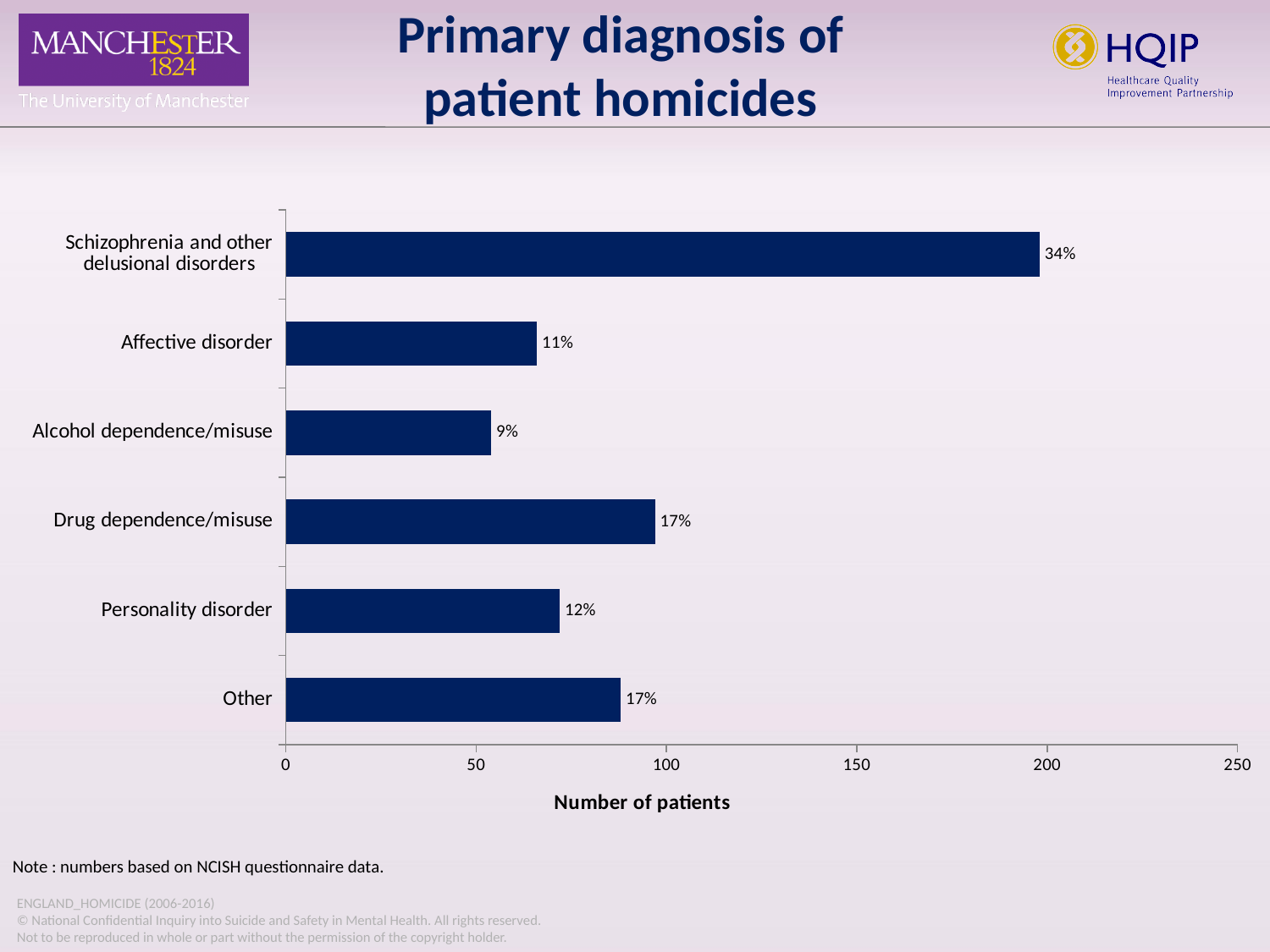
Is the number of patients for Other greater or less than 100? less Is the number of patients for Schizophrenia and other delusional disorders greater or less than 150? greater What percentage label is shown for Alcohol dependence/misuse? 9% How many diagnosis categories are shown in the chart? 6 Which primary diagnosis has the highest number of patients? Schizophrenia and other delusional disorders Which has more patients, Drug dependence/misuse or Personality disorder? Drug dependence/misuse What percentage label is shown for Personality disorder? 12% What is the label of the horizontal axis? Number of patients What percentage label is shown for Drug dependence/misuse? 17% What percentage label is shown for Schizophrenia and other delusional disorders? 34% What type of chart is shown on the slide? Bar chart Which primary diagnosis has the lowest number of patients? Alcohol dependence/misuse